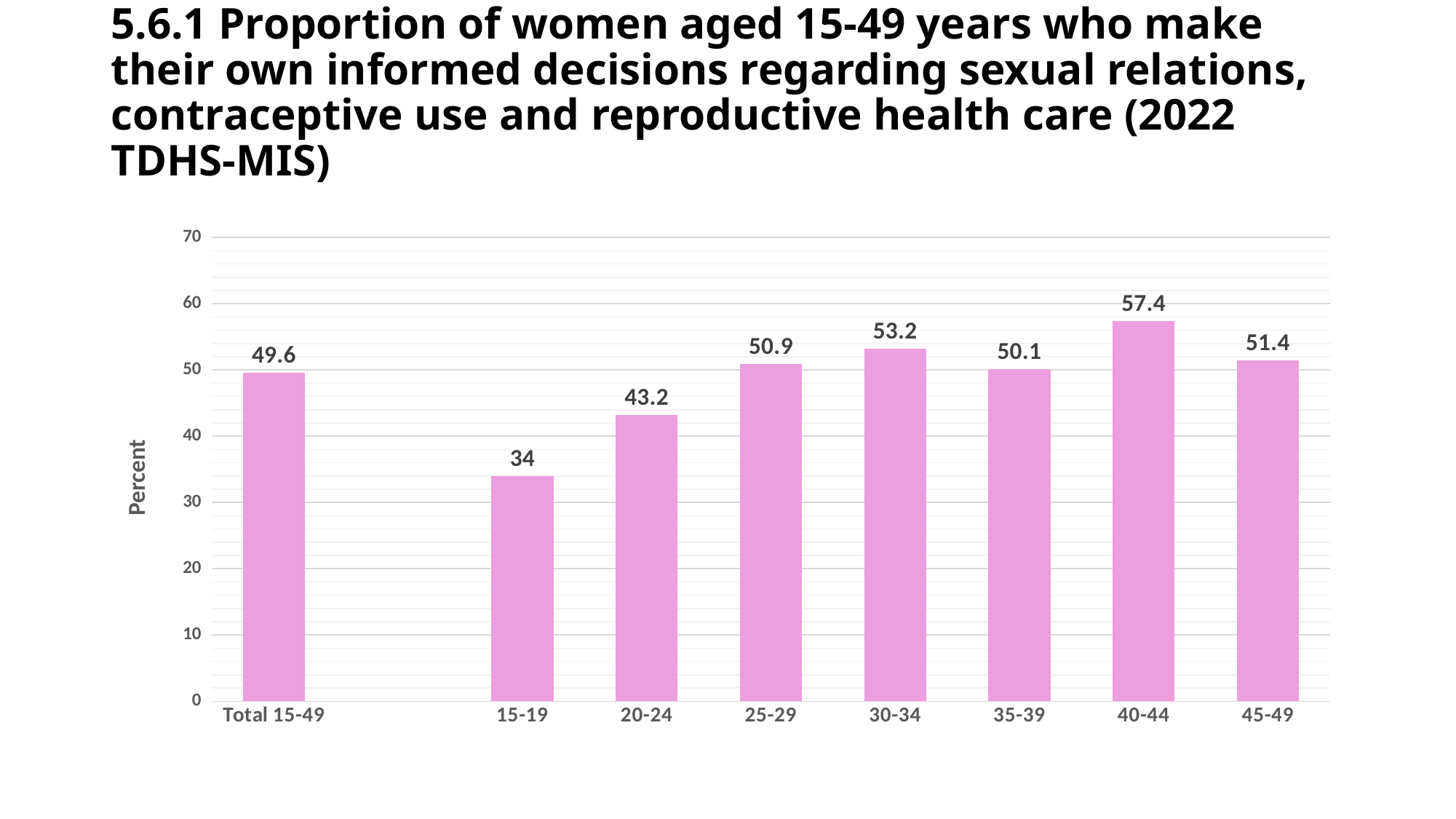
Which age group has the highest value? 40-44 Is the value for 20-24 greater or less than 40? greater What is the label on the y axis? Percent Which is larger, the value for 30-34 or the value for 45-49? 30-34 What is the value for the 15-19 age group? 34 How many categories are shown on the x axis? 8 What kind of chart is shown on the slide? bar chart What is the value for the Total 15-49 category? 49.6 Do the values rise or fall from the 15-19 group to the 30-34 group? rise What is the difference between the values for 40-44 and 15-19? 23.4 What is the value for the 40-44 age group? 57.4 Which age group has the lowest value? 15-19